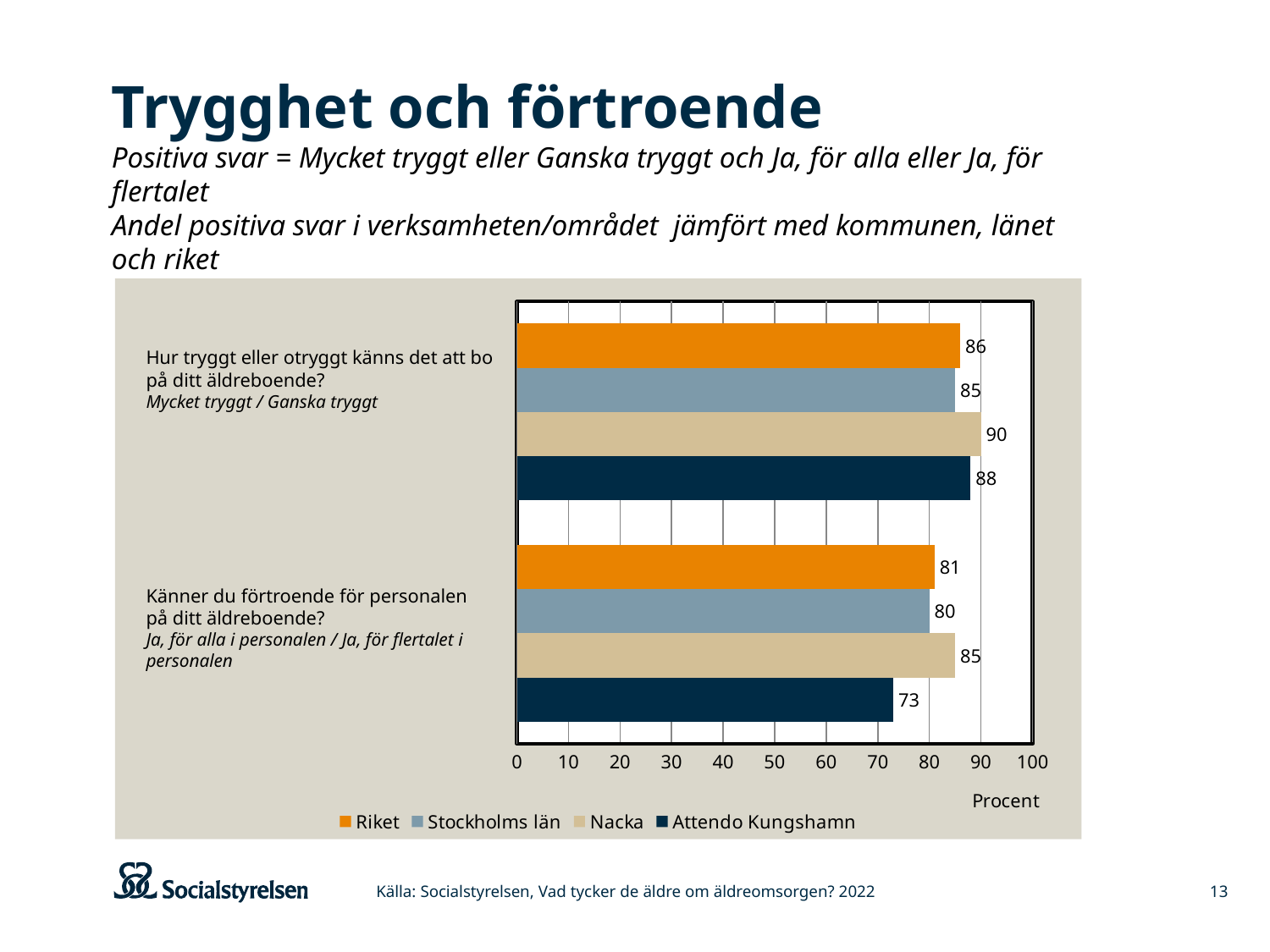
What is the value for Attendo Kungshamn on the question "Känner du förtroende för personalen på ditt äldreboende?"? 73 How many series does the legend list? 4 What is the value for Riket on the question "Känner du förtroende för personalen på ditt äldreboende?"? 81 How many question categories are shown on the chart? 2 What is the value for Stockholms län on the question "Hur tryggt eller otryggt känns det att bo på ditt äldreboende?"? 85 Which series has the lowest value on the question "Känner du förtroende för personalen på ditt äldreboende?"? Attendo Kungshamn Which series has the highest value on the question "Hur tryggt eller otryggt känns det att bo på ditt äldreboende?"? Nacka What is the difference between Nacka and Attendo Kungshamn on the question "Känner du förtroende för personalen på ditt äldreboende?"? 12 What is the value for Nacka on the question "Hur tryggt eller otryggt känns det att bo på ditt äldreboende?"? 90 Which is larger on the question "Hur tryggt eller otryggt känns det att bo på ditt äldreboende?": Attendo Kungshamn or Riket? Attendo Kungshamn What kind of chart is shown on the slide? Bar chart What is the label of the x axis? Procent